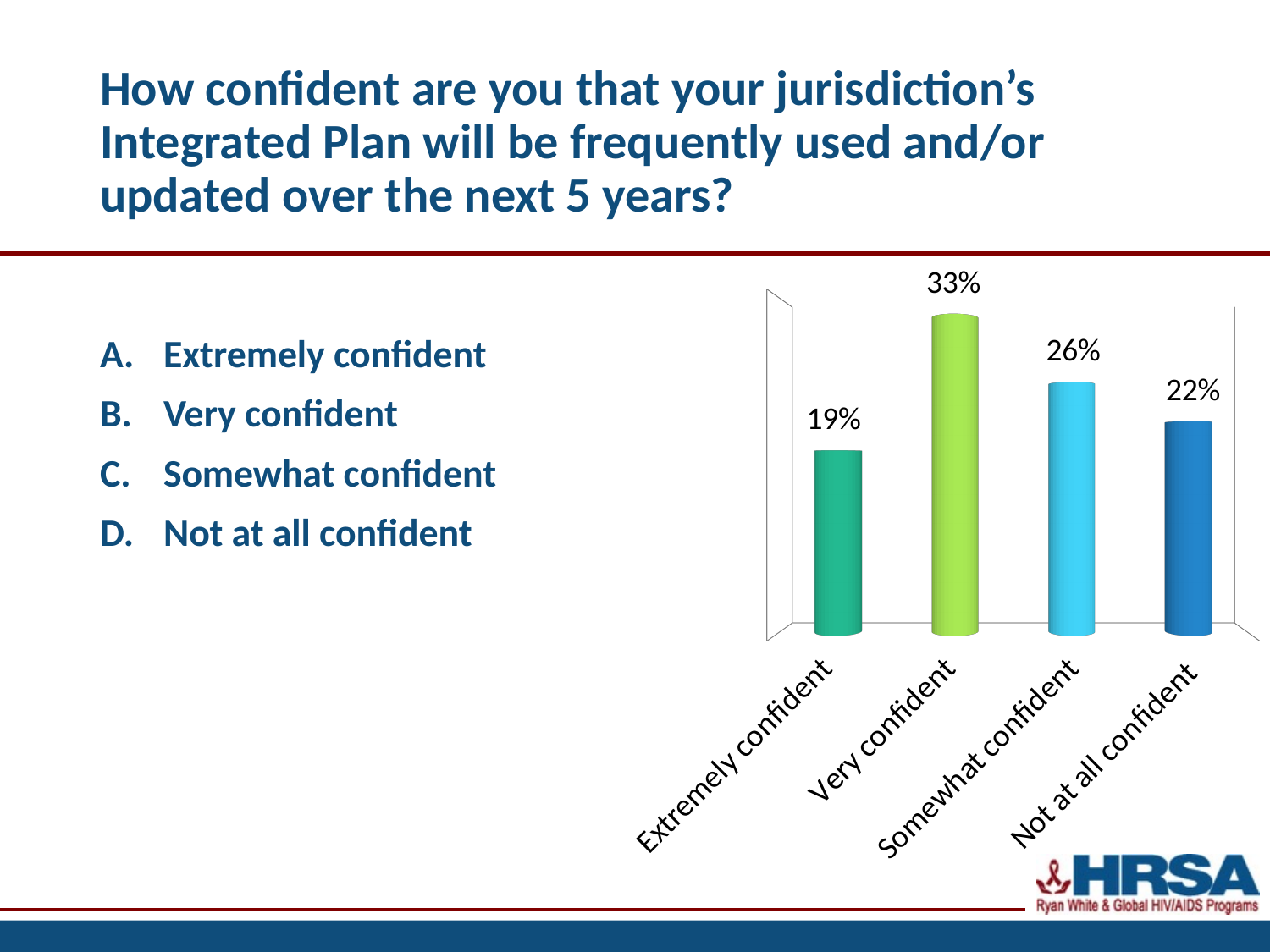
How many categories are shown in the chart? 4 Which category has the highest value? Very confident What colour is the bar for Very confident? Green What is the value for Not at all confident? 22% What kind of chart is shown on the slide? Bar chart Which category has the lowest value? Extremely confident What is the difference between the values for Very confident and Extremely confident? 14% What is the difference between the values for Somewhat confident and Not at all confident? 4% What is the value for Very confident? 33% What is the value for Extremely confident? 19% What is the value for Somewhat confident? 26% Which is larger, the value for Somewhat confident or the value for Not at all confident? Somewhat confident